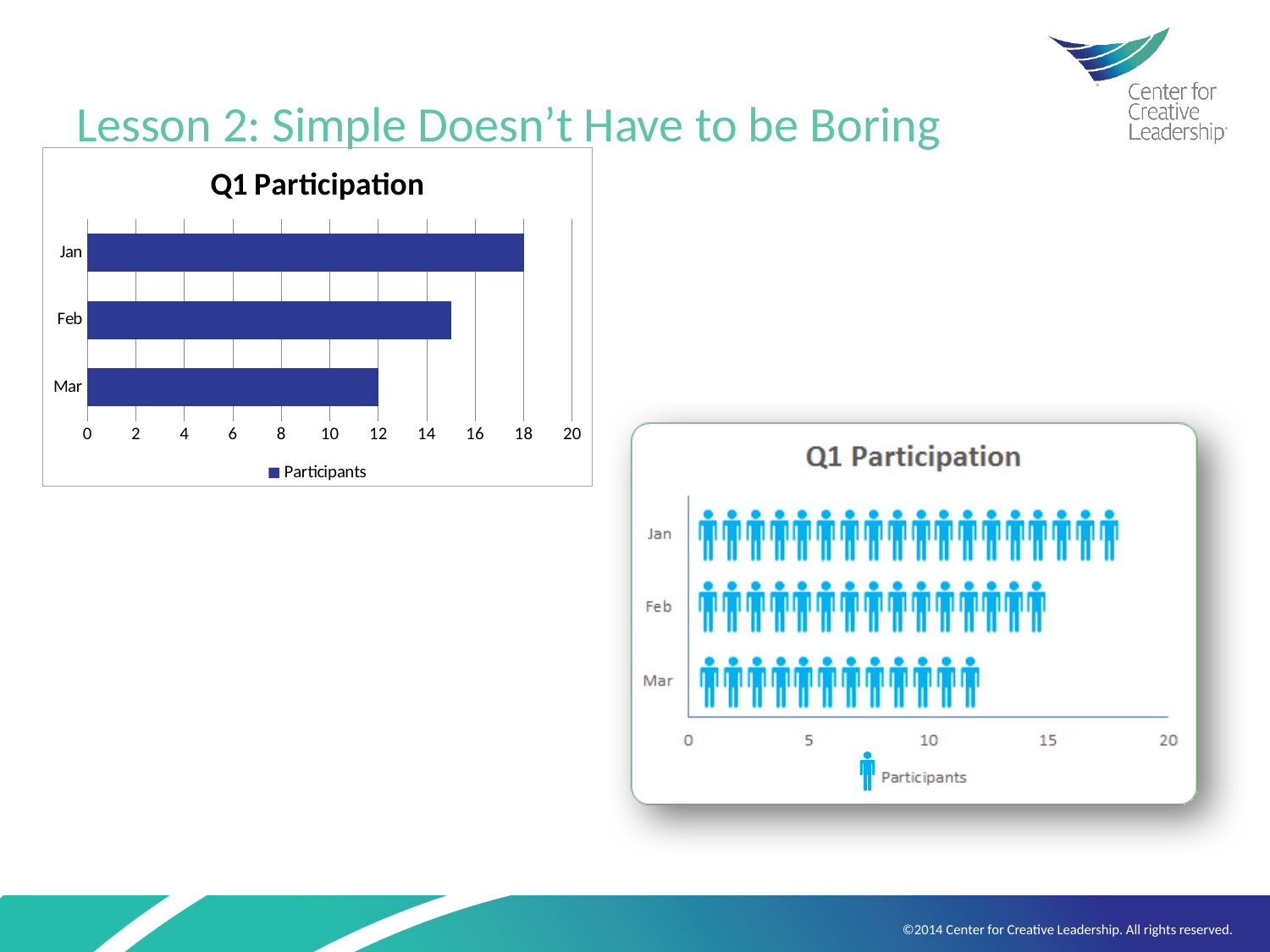
In the bar chart on the left, how many series does the legend list? 1 In the pictogram chart on the right, what is the value for Feb? 15 In the bar chart on the left, which month has the lowest value? Mar What kind of chart is the chart on the left? Bar chart In the bar chart on the left, how many months are shown? 3 In the bar chart on the left, what is the value for Mar? 12 In the pictogram chart on the right, is the value for Jan greater or less than 15? greater In the bar chart on the left, is the value for Feb greater or less than 14? greater In the bar chart on the left, which month has the highest value? Jan In the bar chart on the left, which is larger, the value for Feb or the value for Mar? Feb In the bar chart on the left, what is the value for Jan? 18 In the bar chart on the left, what is the difference between the values for Jan and Mar? 6